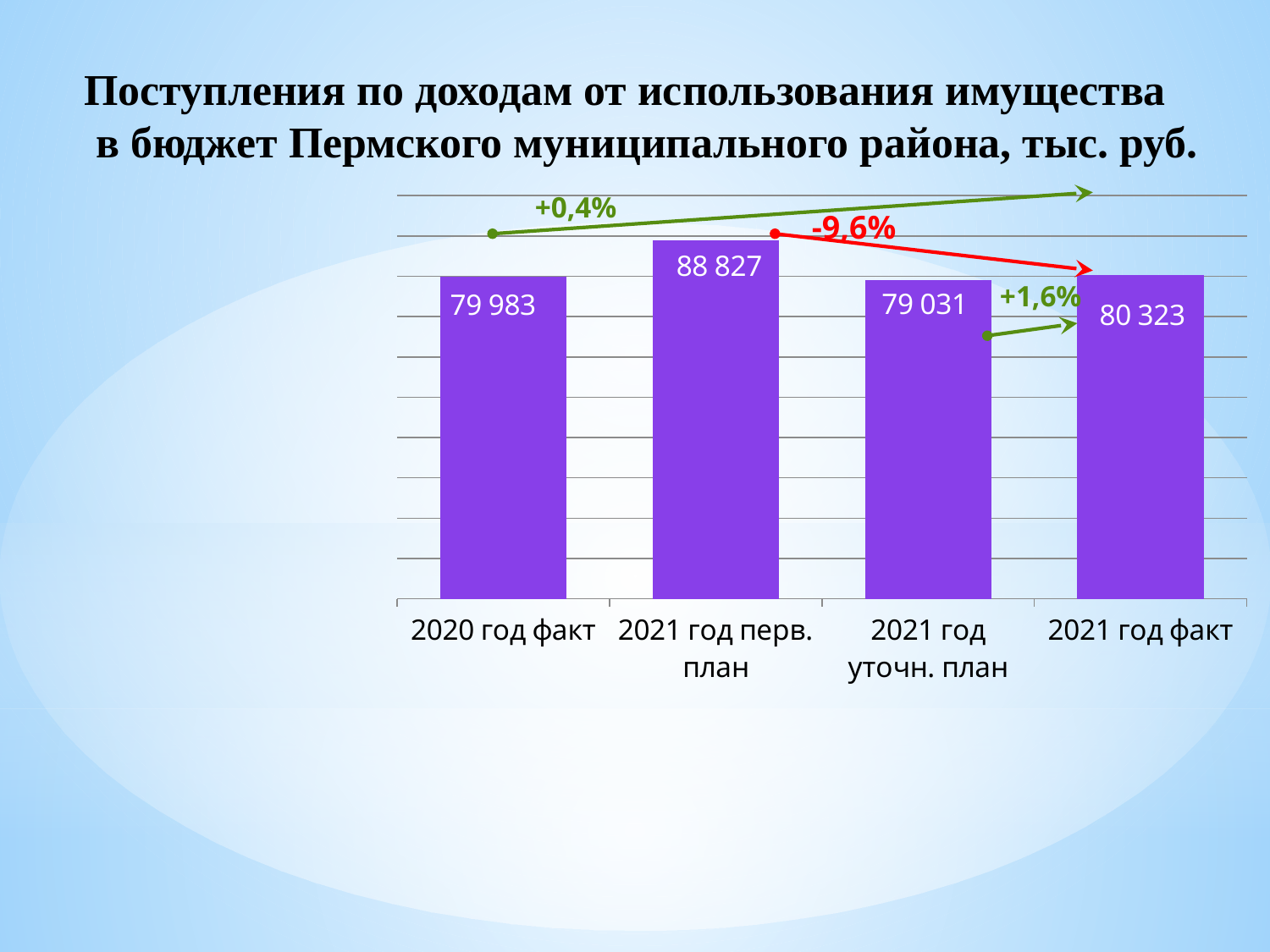
What percentage change is annotated between 2021 год перв. план and 2021 год факт? -9,6% What kind of chart is shown on the slide? bar chart How many categories are shown in the chart? 4 Which is larger, the value for 2020 год факт or the value for 2021 год перв. план? 2021 год перв. план What is the difference between the values for 2021 год факт and 2021 год уточн. план? 1 292 What is the value for 2021 год факт? 80 323 What is the value for 2021 год перв. план? 88 827 Which category has the highest value? 2021 год перв. план What is the value for 2020 год факт? 79 983 What is the difference between the values for 2021 год перв. план and 2021 год факт? 8 504 What is the value for 2021 год уточн. план? 79 031 Which category has the lowest value? 2021 год уточн. план